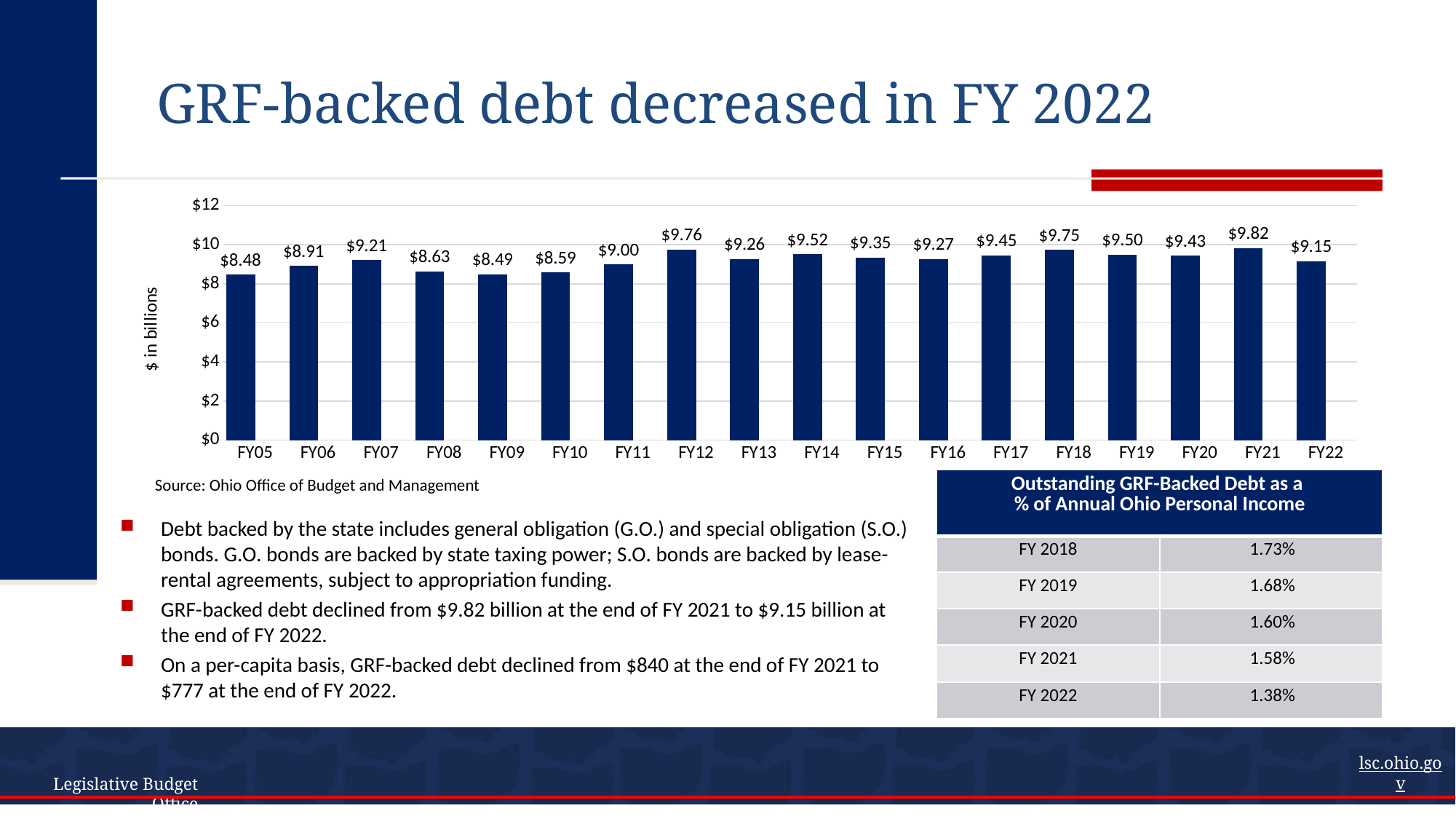
Which is larger in the chart, the value for FY18 or the value for FY19? FY18 How many fiscal years are plotted in the chart? 18 What is the value for FY05 in the chart? $8.48 What is the difference between the FY21 and FY22 values in the chart? $0.67 What is the label on the vertical axis of the chart? $ in billions Is the value for FY09 greater or less than $10? less Which fiscal year has the highest value in the chart? FY21 Do the values rise or fall from FY05 to FY07? rise What type of chart is shown on the slide? bar chart What is the value for FY22 in the chart? $9.15 What is the value for FY12 in the chart? $9.76 What source is cited below the chart? Ohio Office of Budget and Management